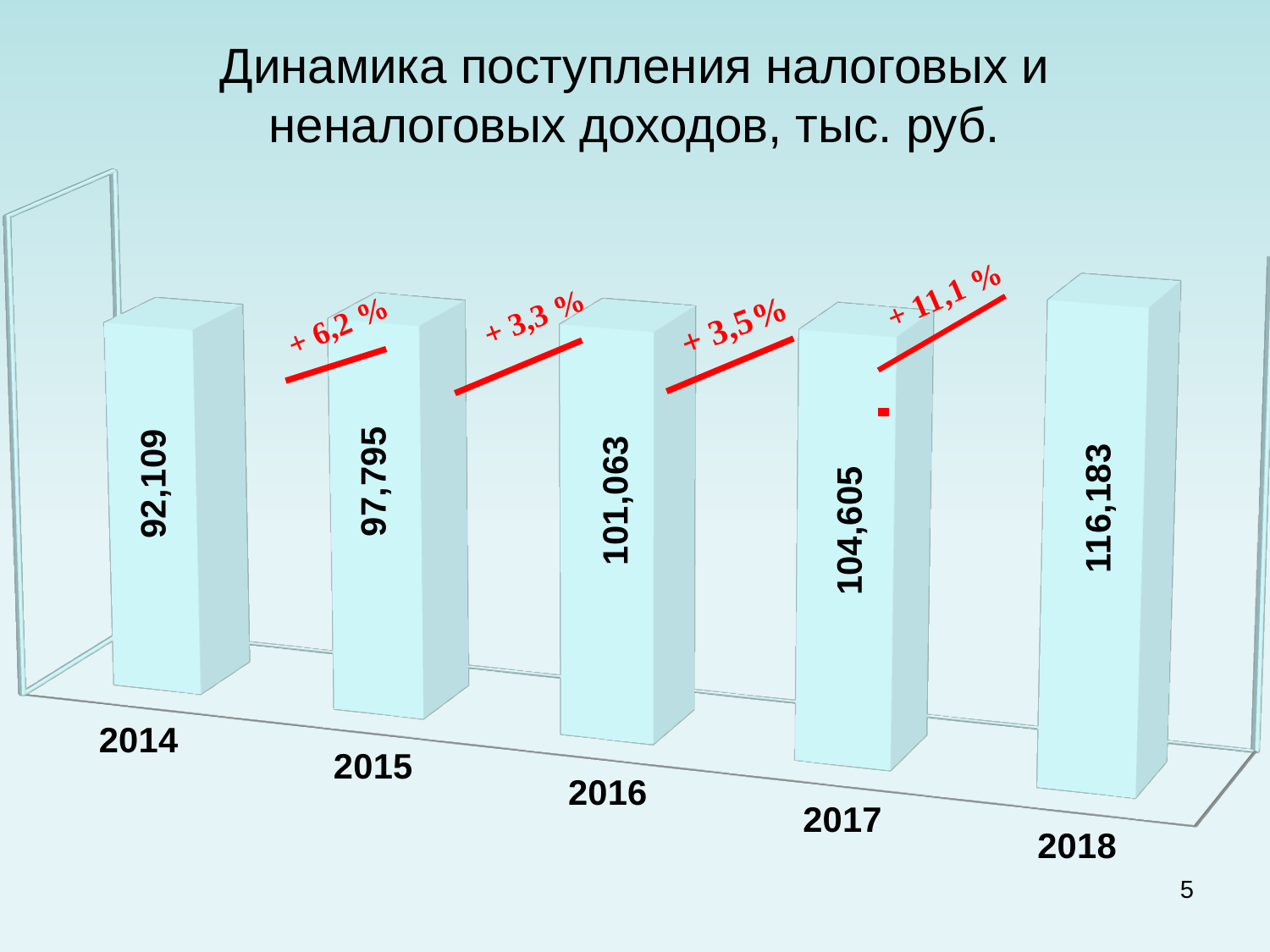
What is the difference between the values for 2015 and 2014? 5,686 What is the value for 2018? 116,183 What is the value for 2014? 92,109 Which year has the highest value? 2018 How many years are shown on the chart? 5 Which is larger, the value for 2017 or the value for 2016? 2017 What percentage change is annotated between 2017 and 2018? + 11,1 % What is the difference between the values for 2018 and 2014? 24,074 What kind of chart is this? bar chart Which year has the lowest value? 2014 Do the values rise or fall from 2014 to 2018? rise What is the value for 2016? 101,063